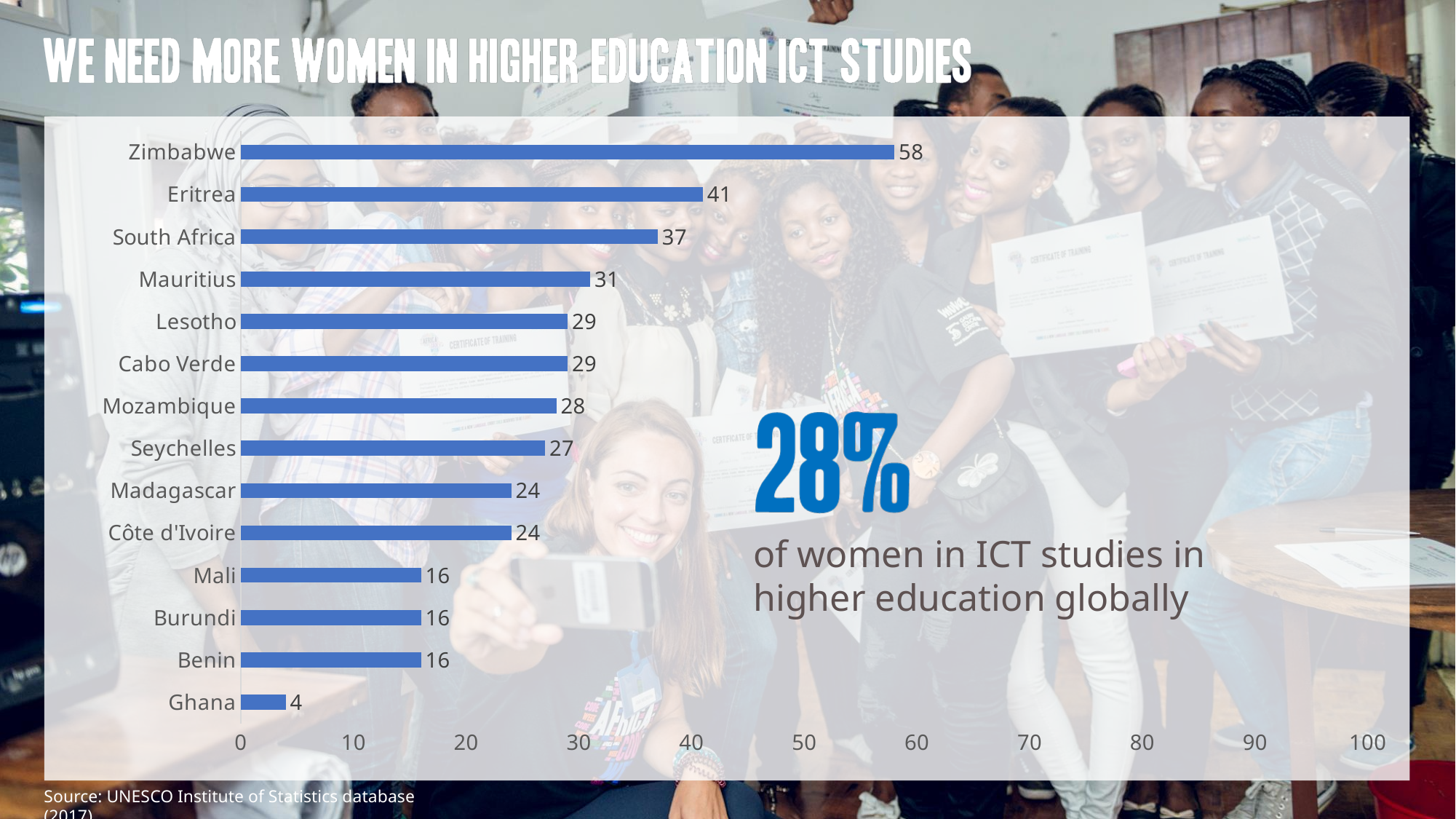
What is the value for Ghana? 4 Which country has the lowest value? Ghana What is the difference between the values for Zimbabwe and Eritrea? 17 Which has a larger value, Mauritius or Seychelles? Mauritius What kind of chart is shown on the slide? bar chart What is the value for South Africa? 37 Which country has the highest value? Zimbabwe What is the value for Zimbabwe? 58 How many countries are shown in the chart? 14 Is the value for Eritrea greater or less than 40? greater What is the value for Madagascar? 24 What is the highest value shown on the horizontal axis? 100